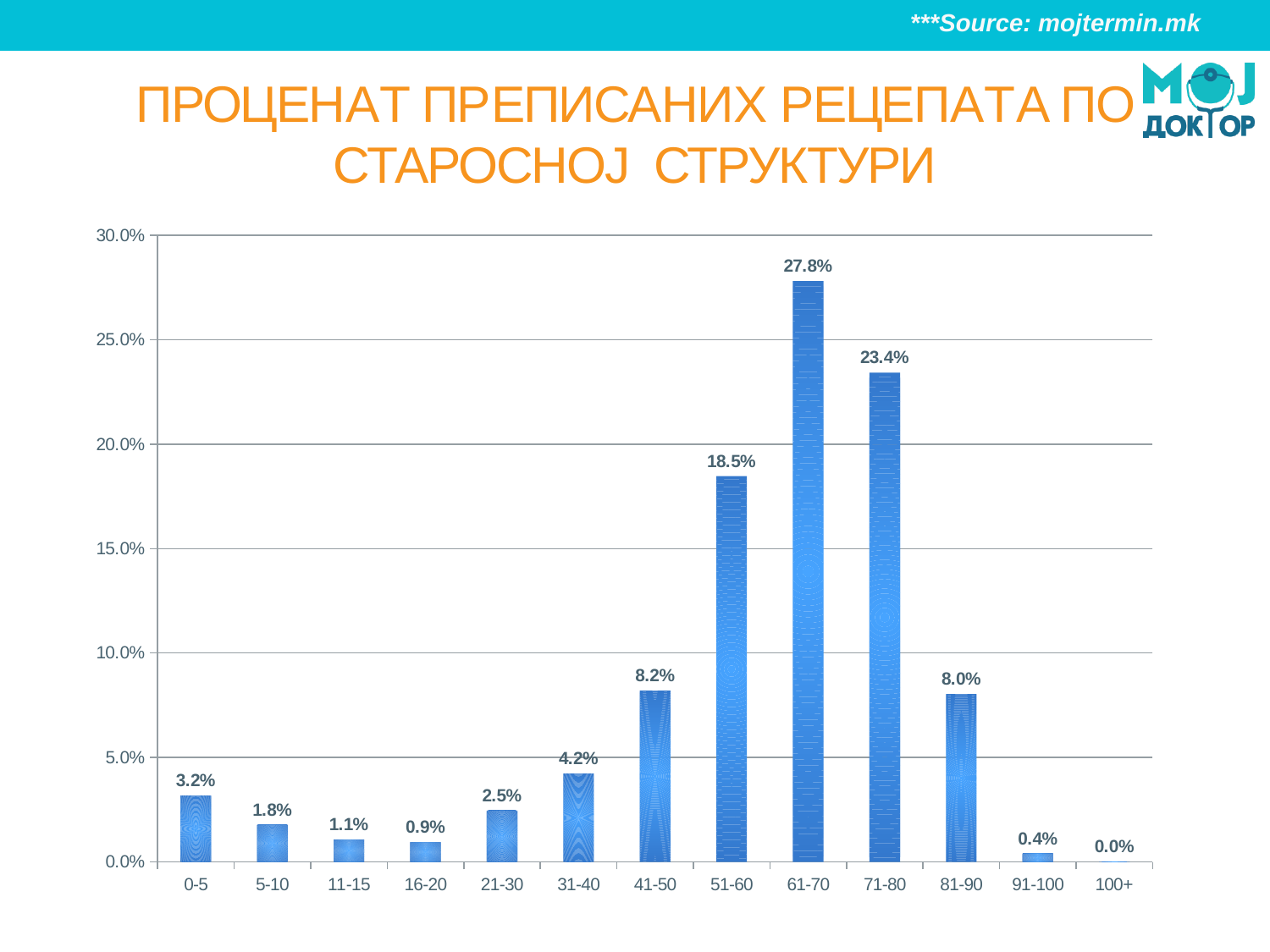
What is the value for the 81-90 age group? 8.0% Which age group has the lowest percentage? 100+ What kind of chart is shown on the slide? bar chart What is the value for the 0-5 age group? 3.2% What is the source cited at the top of the slide? mojtermin.mk Which is larger, the value for 41-50 or the value for 81-90? 41-50 How many age groups are shown on the x axis? 13 Which age group has the highest percentage? 61-70 What is the difference between the values for 51-60 and 41-50? 10.3% What is the difference between the values for 61-70 and 71-80? 4.4% What is the value for the 61-70 age group? 27.8% Is the value for 51-60 greater or less than 15.0%? greater